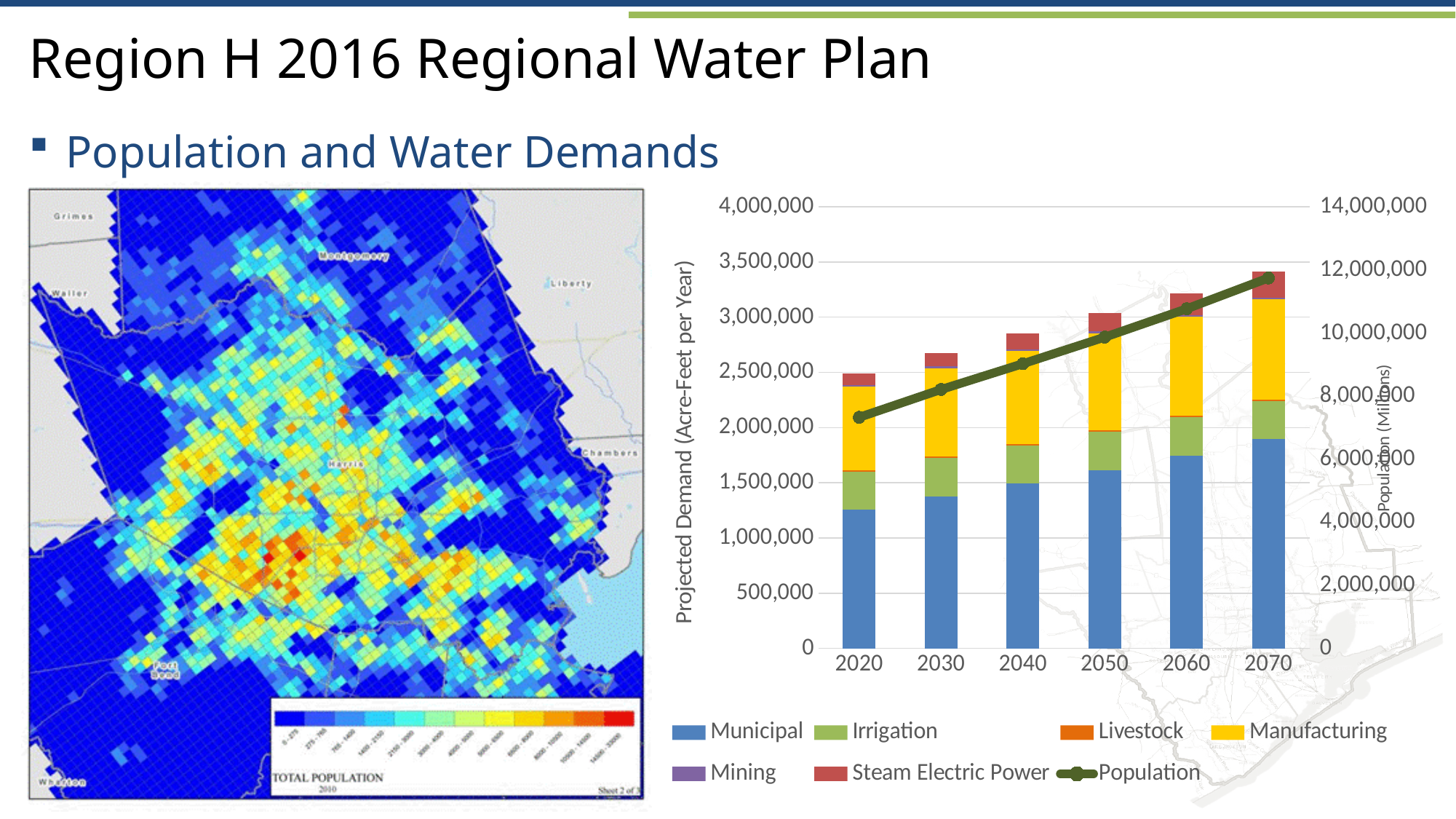
Does the Population line rise or fall from 2020 to 2070? rise Does the total projected demand rise or fall from 2020 to 2070? rise How many series does the legend of the bar chart list? 7 Is the Municipal demand for 2020 greater or less than 1,500,000? less Which year has the lowest total projected demand in the bar chart? 2020 Which year has the highest total projected demand in the bar chart? 2070 Is the total projected demand for 2070 greater or less than 3,000,000? greater Is the Municipal demand for 2070 greater or less than 1,500,000? greater What kind of chart is shown on the right side of the slide? combination bar and line chart What is the title of the left vertical axis of the bar chart? Projected Demand (Acre-Feet per Year) How many years are shown along the x axis of the bar chart? 6